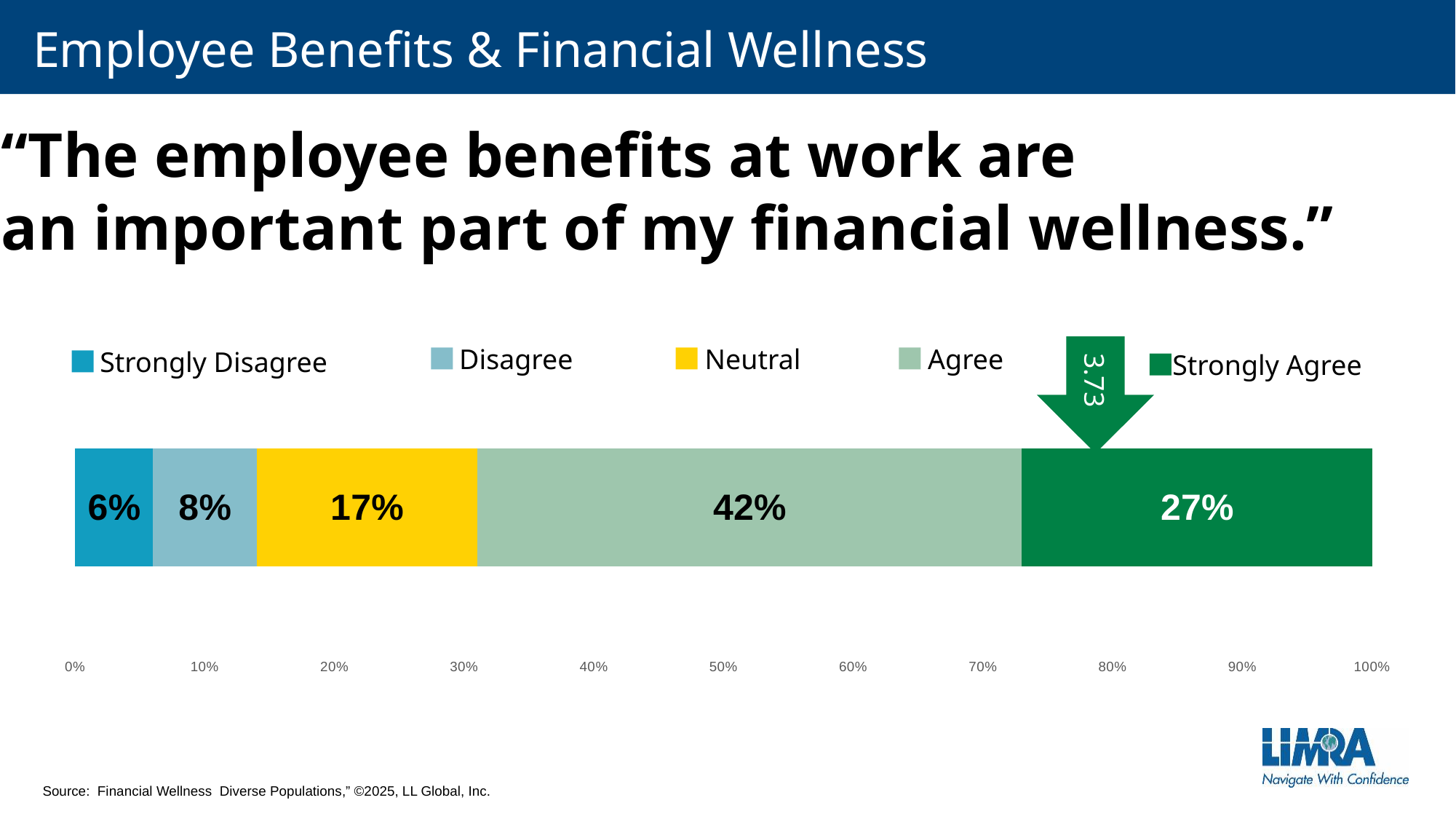
What percentage of respondents answered Strongly Agree? 27% What is the difference in percentage points between Agree and Strongly Agree? 15 What number is printed on the green arrow above the bar? 3.73 What percentage of respondents answered Neutral? 17% What percentage of respondents answered Strongly Disagree? 6% What is the combined percentage of Agree and Strongly Agree? 69% What percentage of respondents answered Agree? 42% Which response category has the largest share? Agree What kind of chart is shown on the slide? Stacked bar chart How many response categories does the legend list? 5 Which response category has the smallest share? Strongly Disagree Which is larger, the share for Disagree or the share for Neutral? Neutral